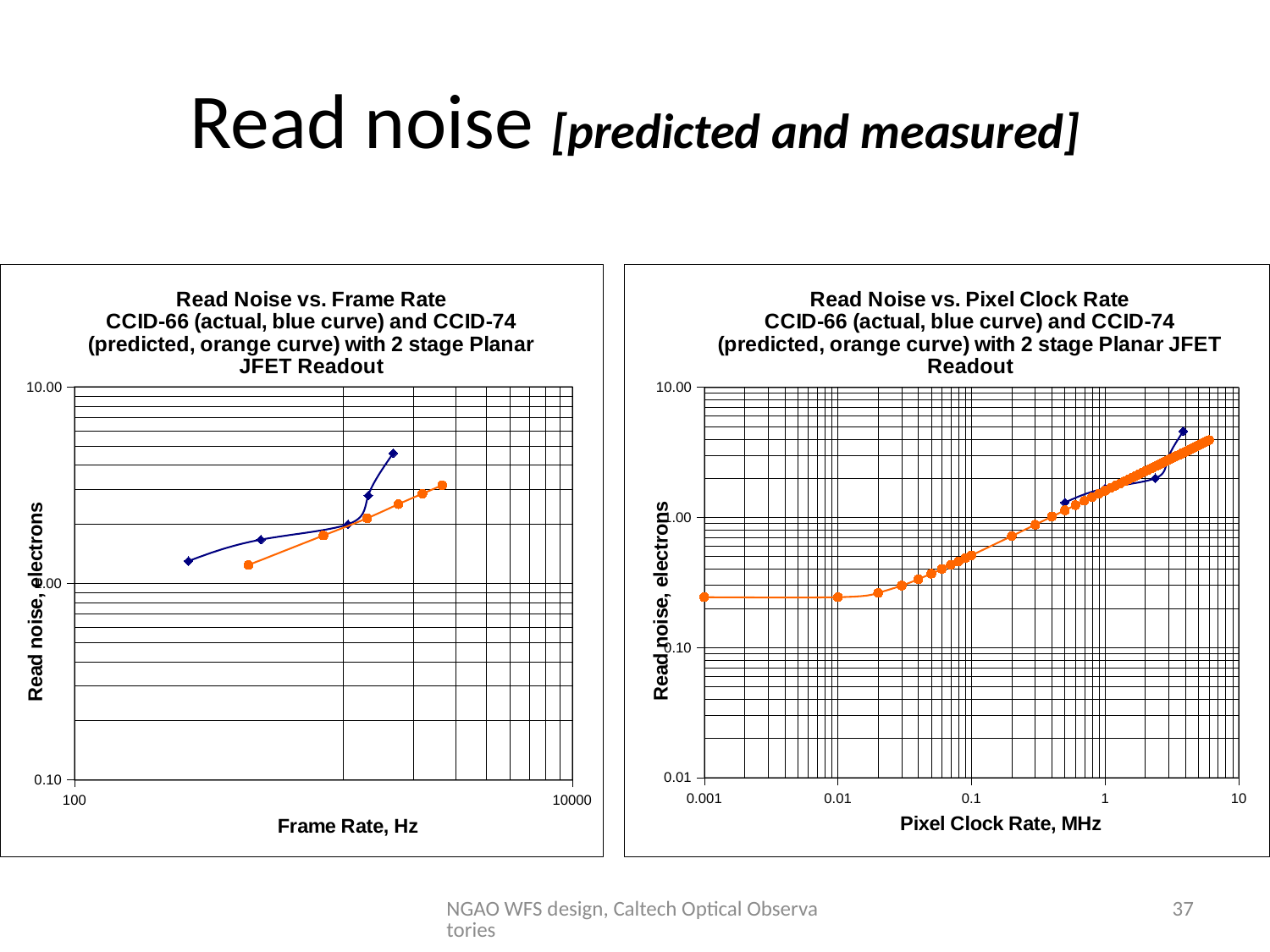
In the left chart, 'Read Noise vs. Frame Rate', does the blue curve rise or fall as frame rate increases? Rise In the left chart, 'Read Noise vs. Frame Rate', is the lowest value of the blue curve greater or less than 1.00? greater In the left chart, 'Read Noise vs. Frame Rate', does the orange curve rise or fall as frame rate increases? Rise In the left chart, 'Read Noise vs. Frame Rate', which curve reaches a higher read noise value, the blue curve or the orange curve? Blue curve In the right chart, 'Read Noise vs. Pixel Clock Rate', is the orange curve's value at 0.1 MHz greater or less than 1.00? less What kind of chart is the right chart, 'Read Noise vs. Pixel Clock Rate'? Line chart What kind of chart is the left chart, 'Read Noise vs. Frame Rate'? Line chart In the right chart, 'Read Noise vs. Pixel Clock Rate', is the orange curve's value at 0.001 MHz greater or less than 1.00? less According to the chart titles, which colour curve shows the actual CCID-66 data? Blue In the right chart, 'Read Noise vs. Pixel Clock Rate', does the orange curve rise or fall as pixel clock rate increases from 0.1 MHz to 1 MHz? Rise What is the x-axis label of the right chart? Pixel Clock Rate, MHz